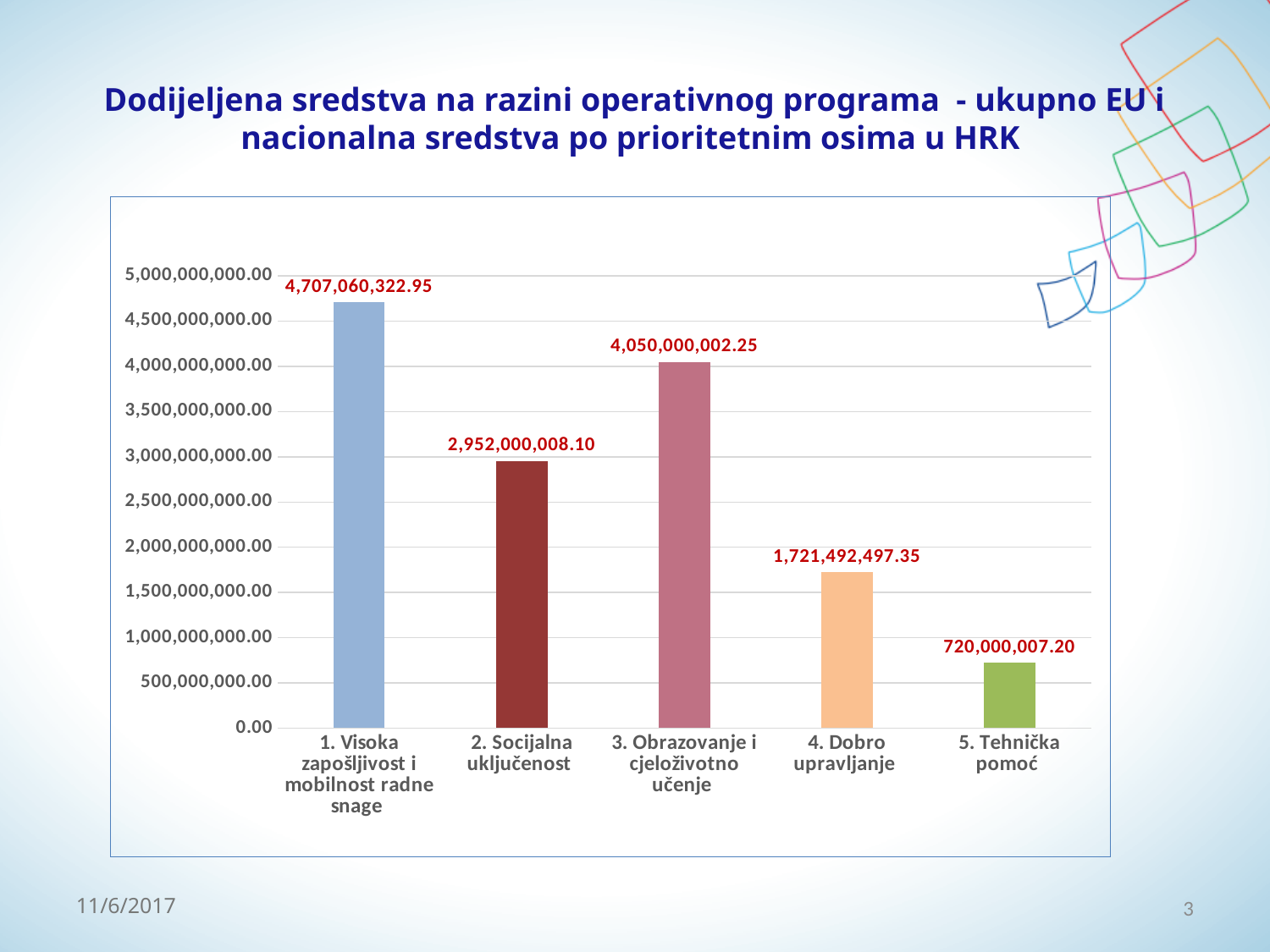
What is the difference between the values for "1. Visoka zapošljivost i mobilnost radne snage" and "3. Obrazovanje i cjeloživotno učenje"? 657,060,320.70 What is the title of the slide containing the chart? Dodijeljena sredstva na razini operativnog programa - ukupno EU i nacionalna sredstva po prioritetnim osima u HRK What is the value for "4. Dobro upravljanje"? 1,721,492,497.35 How many categories are shown on the chart? 5 Which category has the lowest value? 5. Tehnička pomoć What is the value for "2. Socijalna uključenost"? 2,952,000,008.10 Which category has the highest value? 1. Visoka zapošljivost i mobilnost radne snage What kind of chart is shown on the slide? bar chart What is the difference between the values for "3. Obrazovanje i cjeloživotno učenje" and "4. Dobro upravljanje"? 2,328,507,504.90 Is the value for "4. Dobro upravljanje" greater or less than 2,000,000,000.00? less Which is larger, the value for "2. Socijalna uključenost" or the value for "3. Obrazovanje i cjeloživotno učenje"? 3. Obrazovanje i cjeloživotno učenje What is the value for "5. Tehnička pomoć"? 720,000,007.20